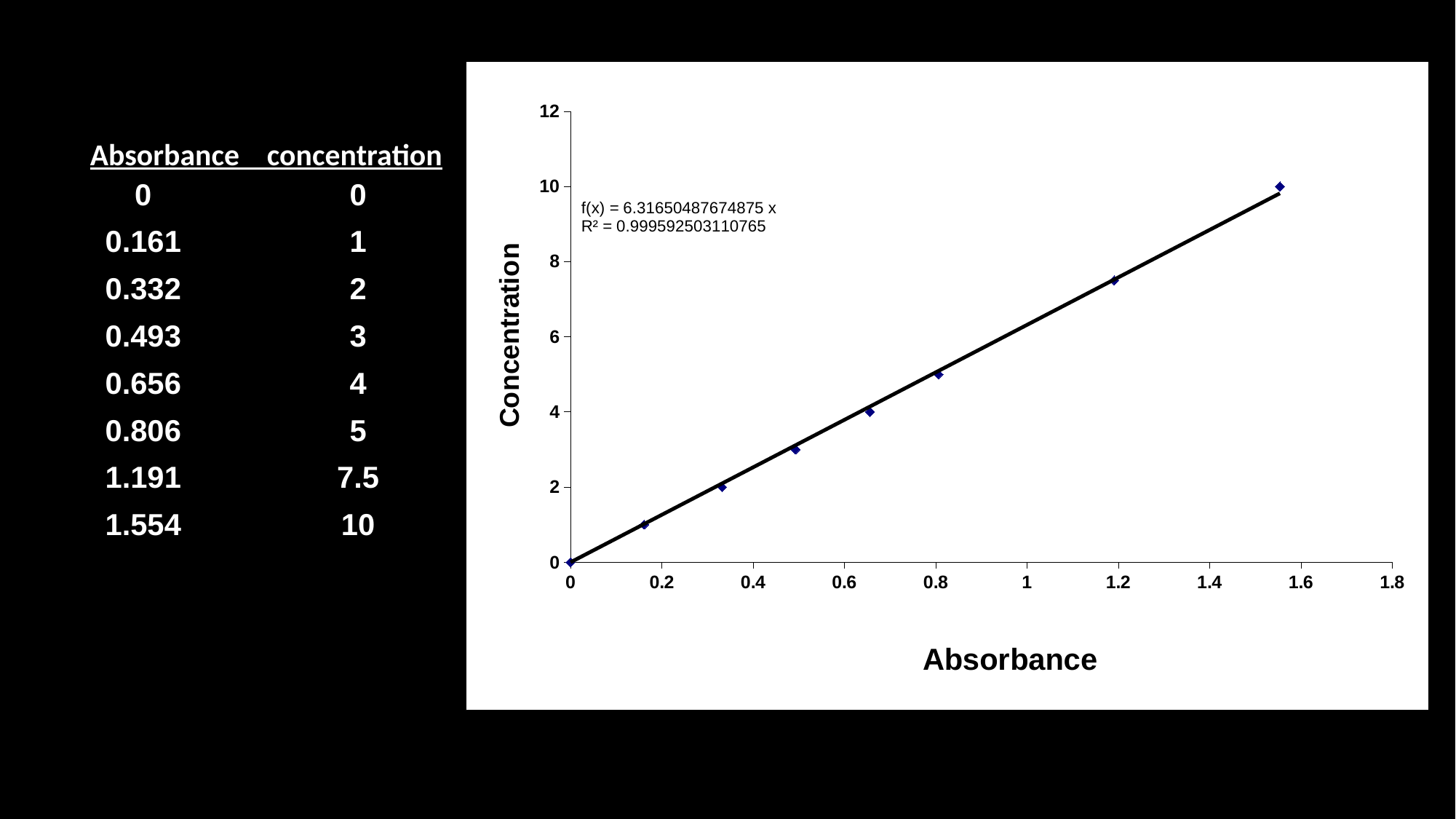
How many data points are plotted on the chart? 8 What is the difference in concentration between the points at absorbance 1.554 and absorbance 0.656? 6 What concentration is plotted for an absorbance of 1.554? 10 What is the label of the y axis of the chart? Concentration What is the lowest concentration value plotted on the chart? 0 What is the label of the x axis of the chart? Absorbance Is the concentration plotted at an absorbance of 1.191 greater or less than 8? less What is the highest concentration value plotted on the chart? 10 What kind of chart is shown on the slide? scatter chart Is the concentration plotted at an absorbance of 0.806 greater or less than 4? greater What concentration is plotted for an absorbance of 0.332? 2 Do the plotted concentration values rise or fall as absorbance increases along the x axis? rise